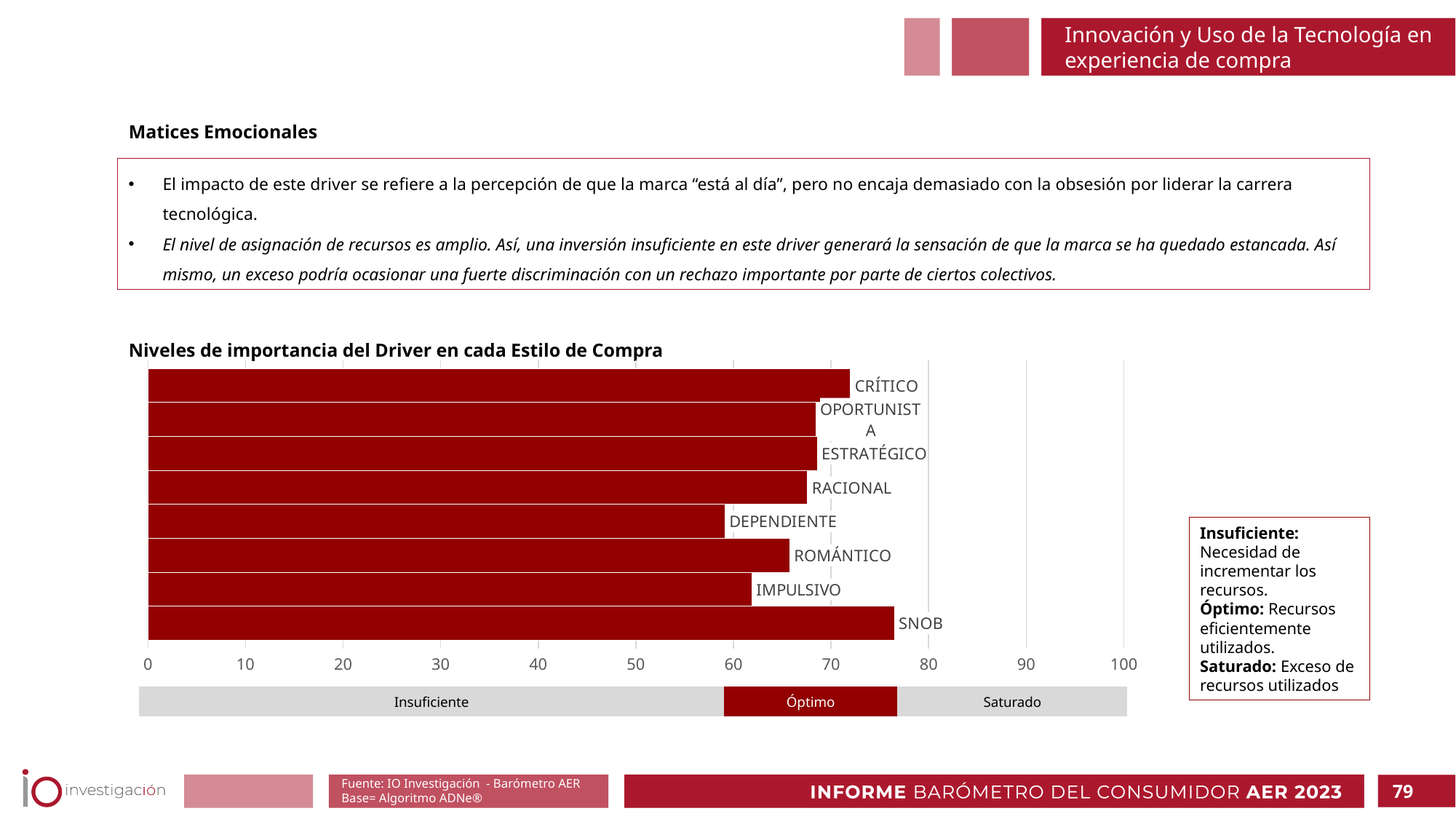
Is the value for CRÍTICO greater or less than 70? greater What are the three zone labels shown in the band below the chart's x axis? Insuficiente, Óptimo, Saturado What is the title of the chart on the slide? Niveles de importancia del Driver en cada Estilo de Compra Is the value for SNOB greater or less than 70? greater Which purchase style has the highest value in the chart? SNOB Which is larger, the value for SNOB or the value for CRÍTICO? SNOB Is the value for ROMÁNTICO greater or less than 70? less Which is larger, the value for ROMÁNTICO or the value for DEPENDIENTE? ROMÁNTICO Which purchase style has the lowest value in the chart? DEPENDIENTE What kind of chart is shown under "Niveles de importancia del Driver en cada Estilo de Compra"? bar chart How many purchase styles (categories) are plotted in the chart? 8